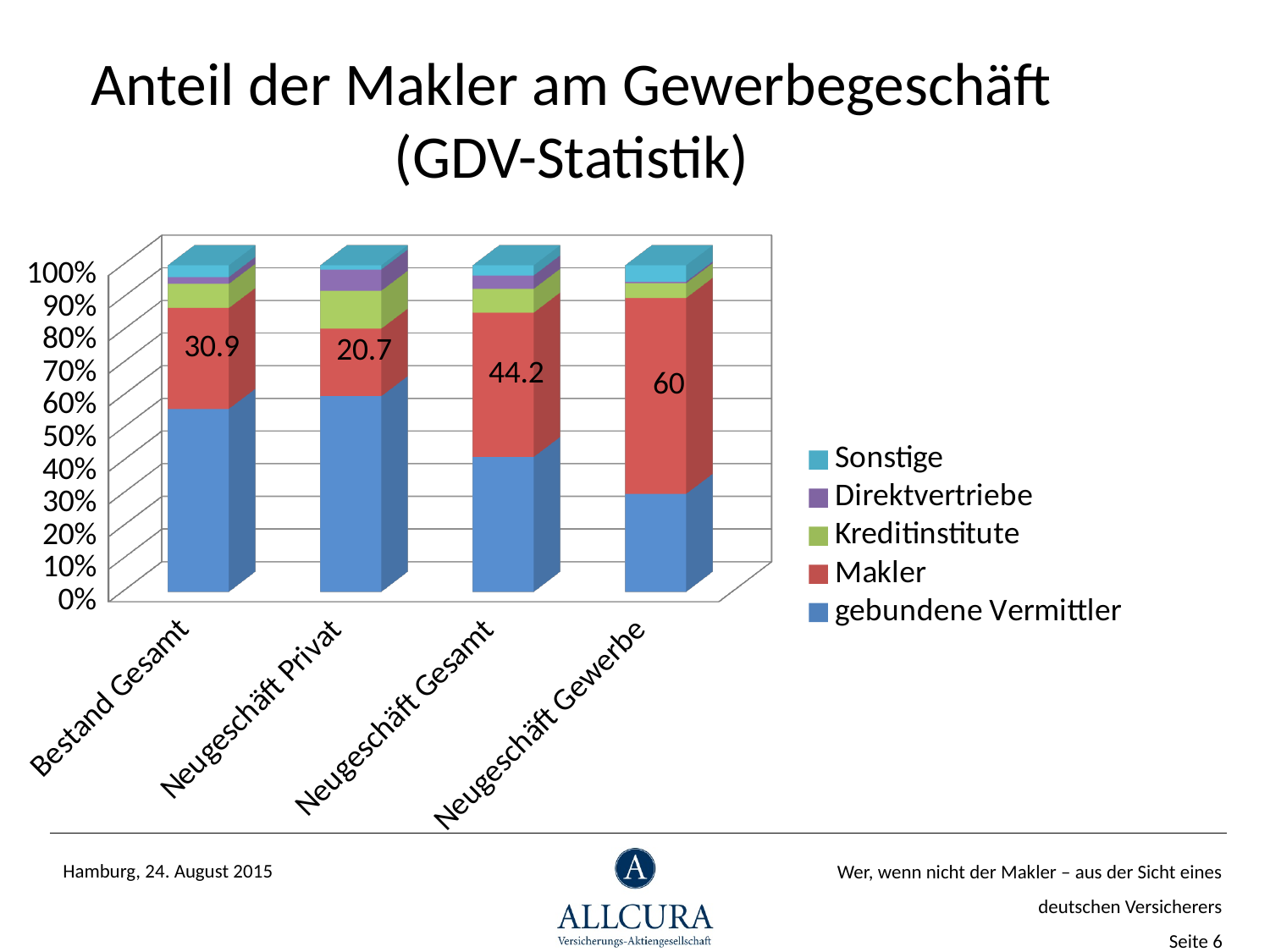
What is the Makler value for Neugeschäft Privat? 20.7 What kind of chart is shown on the slide? Stacked bar chart What is the Makler value for Neugeschäft Gewerbe? 60 How many categories are shown on the x axis? 4 What is the Makler value for Neugeschäft Gesamt? 44.2 Which category has the lowest Makler value? Neugeschäft Privat Which category has the highest Makler value? Neugeschäft Gewerbe What is the difference between the Makler values for Neugeschäft Gewerbe and Neugeschäft Privat? 39.3 Which has a larger Makler value, Bestand Gesamt or Neugeschäft Gesamt? Neugeschäft Gesamt Is the gebundene Vermittler share for Neugeschäft Gewerbe greater or less than 40%? less What is the Makler value for Bestand Gesamt? 30.9 How many series does the legend list? 5